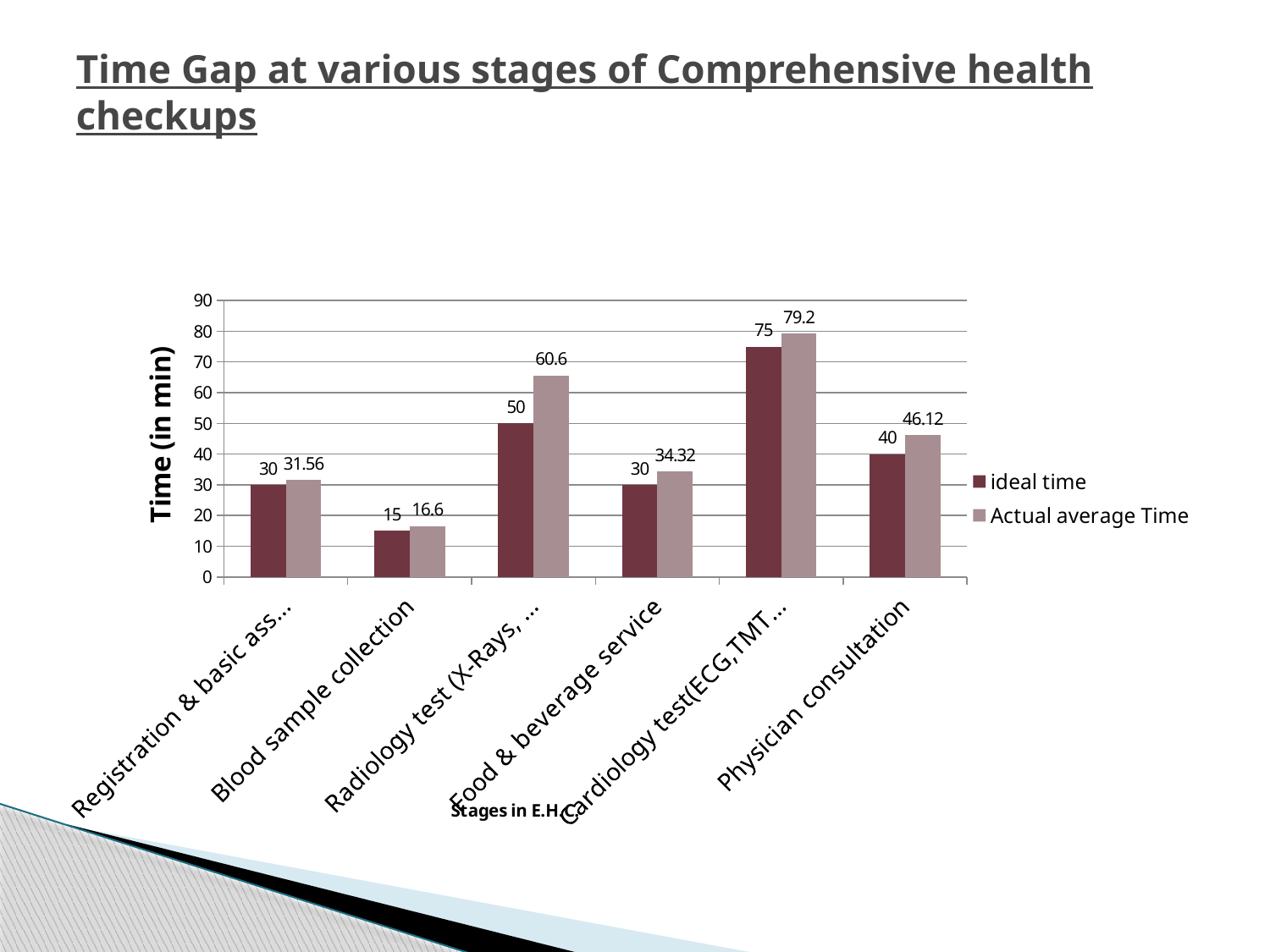
Which stage has the highest Actual average Time? Cardiology test What is the Actual average Time for Food & beverage service? 34.32 What is the difference between the Actual average Time and the ideal time for Physician consultation? 6.12 What kind of chart is shown on the slide? Bar chart How many stages are shown on the x axis? 6 What is the ideal time for Physician consultation? 40 How many series does the legend list? 2 Which stage has the lowest ideal time? Blood sample collection Which is larger for Food & beverage service: the ideal time or the Actual average Time? Actual average Time What is the ideal time for Blood sample collection? 15 What is the Actual average Time for Physician consultation? 46.12 What is the difference between the Actual average Time and the ideal time for Blood sample collection? 1.6